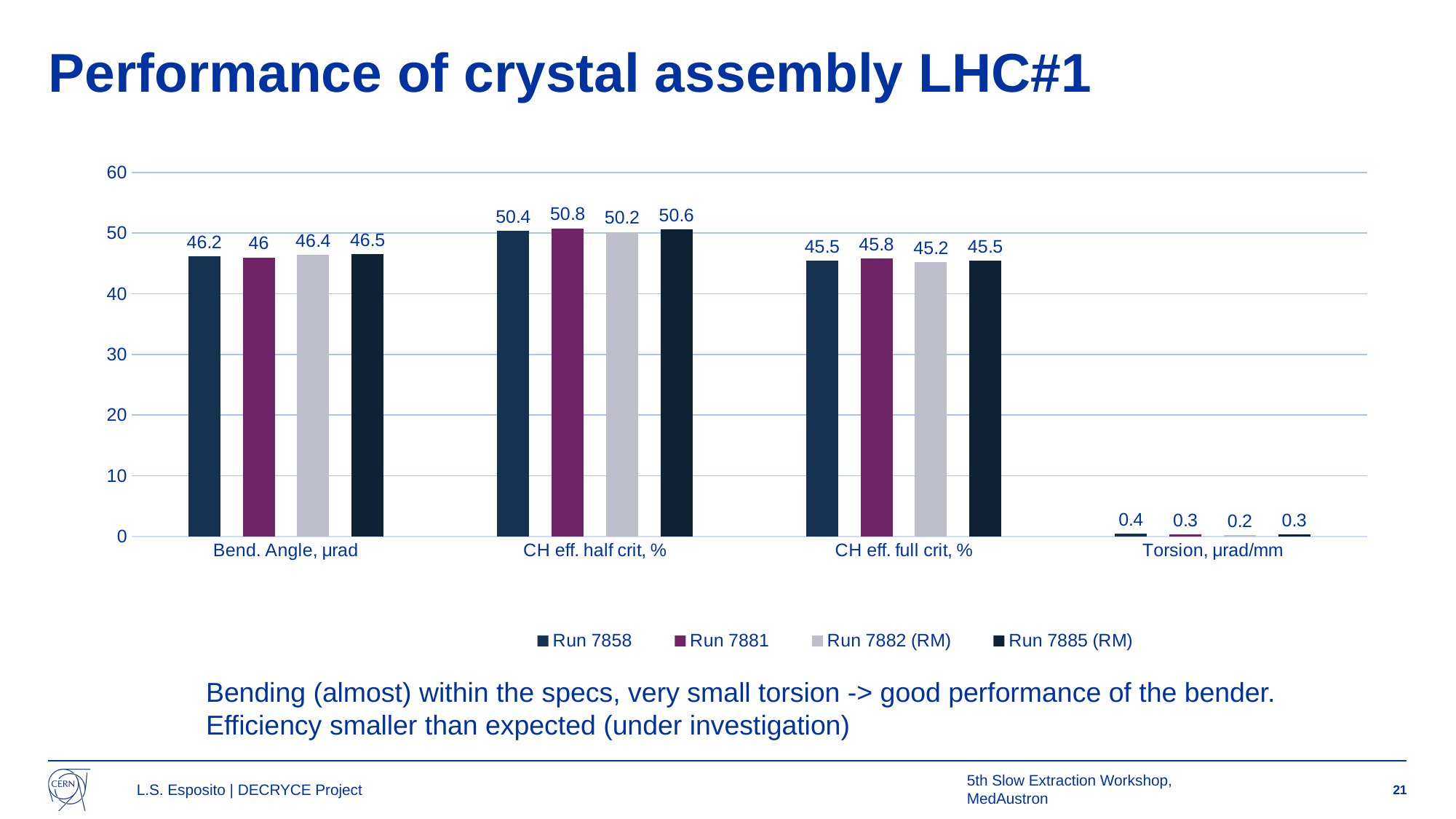
What is the value for Run 7885 (RM) in the CH eff. half crit, % category? 50.6 How many categories are shown on the x axis? 4 What is the value for Run 7858 in the CH eff. full crit, % category? 45.5 Which series has the highest value in the CH eff. half crit, % category? Run 7881 Which is larger: the Run 7858 value for CH eff. half crit, % or the Run 7858 value for CH eff. full crit, %? CH eff. half crit, % What is the value for Run 7882 (RM) in the Torsion, µrad/mm category? 0.2 What is the difference between the Run 7881 and Run 7882 (RM) values in the CH eff. full crit, % category? 0.6 How many series does the legend list? 4 Which series has the lowest value in the Bend. Angle, µrad category? Run 7881 What is the title of the slide containing the chart? Performance of crystal assembly LHC#1 What is the value for Run 7881 in the Bend. Angle, µrad category? 46 What kind of chart is shown on the slide? bar chart